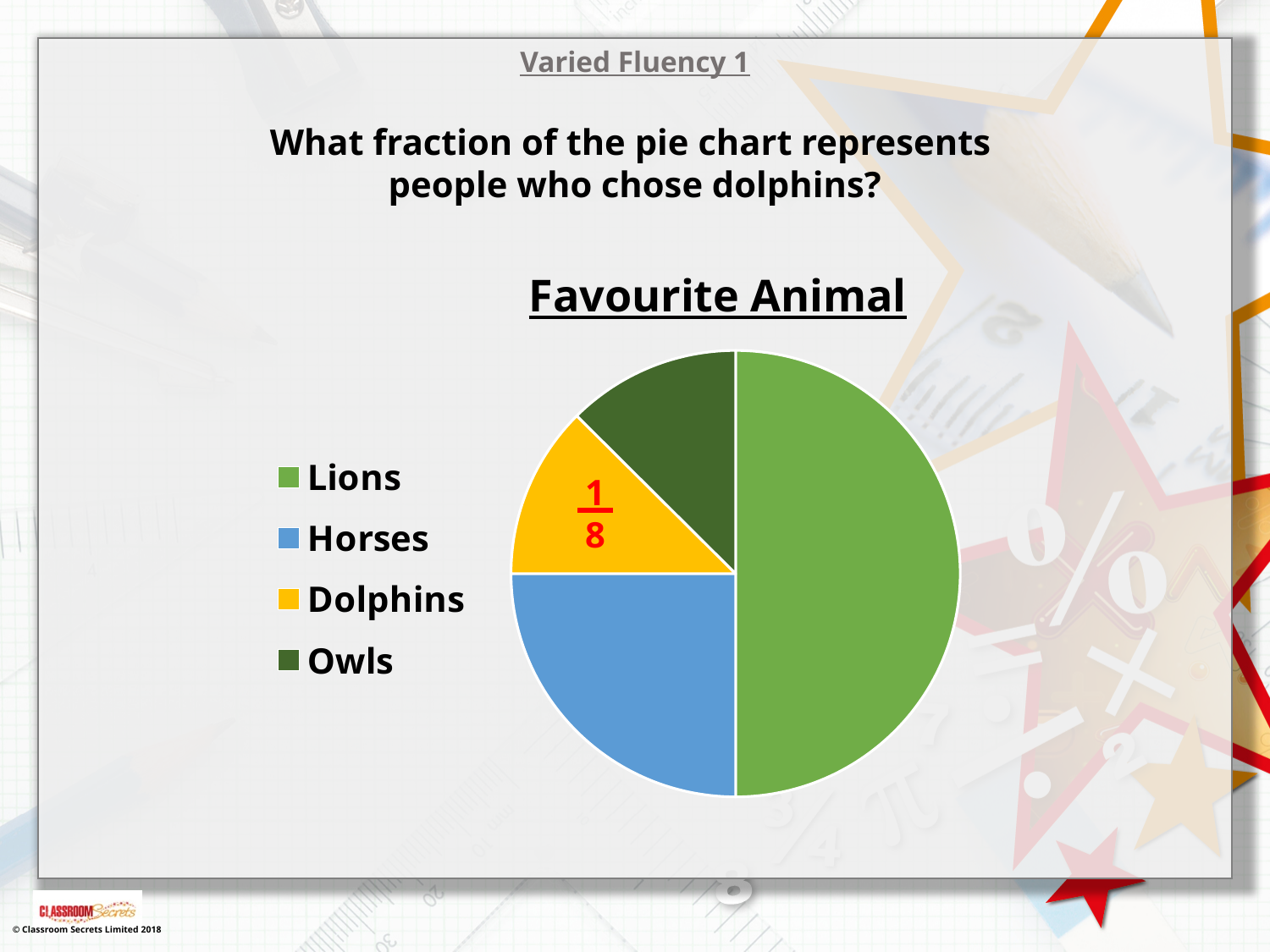
Which animal has the largest slice of the pie chart? Lions Which slice is larger, Lions or Horses? Lions What fraction of the pie chart represents Dolphins? 1/8 Which category is listed first in the legend? Lions Which slice is larger, Horses or Dolphins? Horses How many categories does the pie chart have? 4 What colour is the Dolphins slice in the pie chart? yellow What kind of chart is shown on the slide? pie chart How many entries does the legend list? 4 What is the title of the chart? Favourite Animal Which slice is larger, Lions or Owls? Lions